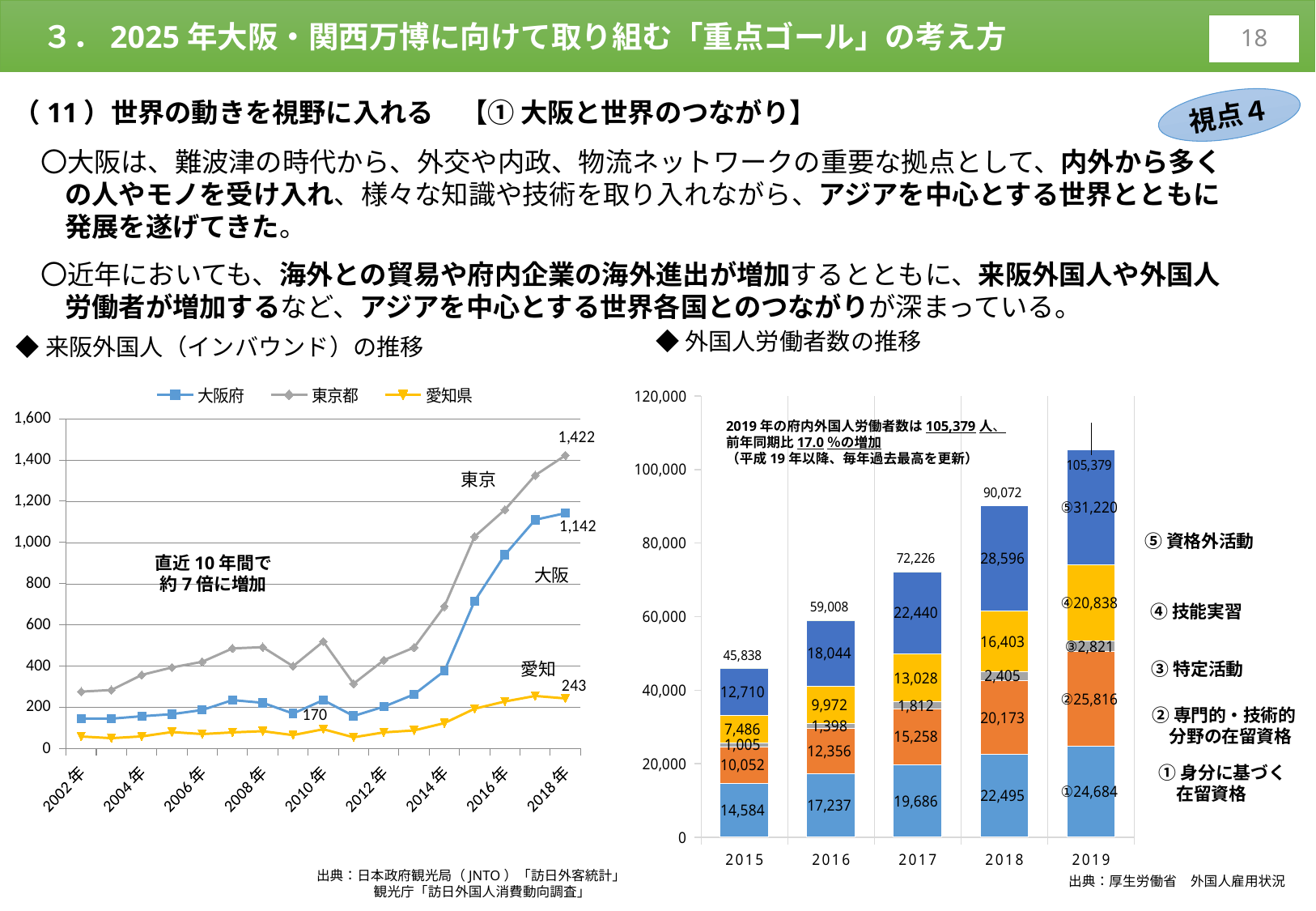
What kind of chart is the 外国人労働者数の推移 chart on the right? Stacked bar chart In the 外国人労働者数の推移 chart on the right, what is the total shown above the 2015 bar? 45,838 In the 来阪外国人（インバウンド）の推移 chart on the left, what is the value for 東京都 in 2018年? 1,422 In the 外国人労働者数の推移 chart on the right, what is the value of the ⑤ 資格外活動 segment for 2018? 28,596 In the 来阪外国人（インバウンド）の推移 chart on the left, does the 大阪府 line rise or fall from 2014年 to 2018年? Rise In the 来阪外国人（インバウンド）の推移 chart on the left, which series has the highest value in 2018年? 東京都 In the 外国人労働者数の推移 chart on the right, by how much did the total increase from 2018 to 2019? 15,307 In the 外国人労働者数の推移 chart on the right, what is the total number of foreign workers shown for 2019? 105,379 In the 来阪外国人（インバウンド）の推移 chart on the left, what is the value for 大阪府 in 2018年? 1,142 In the 外国人労働者数の推移 chart on the right, what is the value of the ④ 技能実習 segment for 2017? 13,028 How many years are shown on the x axis of the 外国人労働者数の推移 chart on the right? 5 How many series does the legend of the 来阪外国人（インバウンド）の推移 chart on the left list? 3